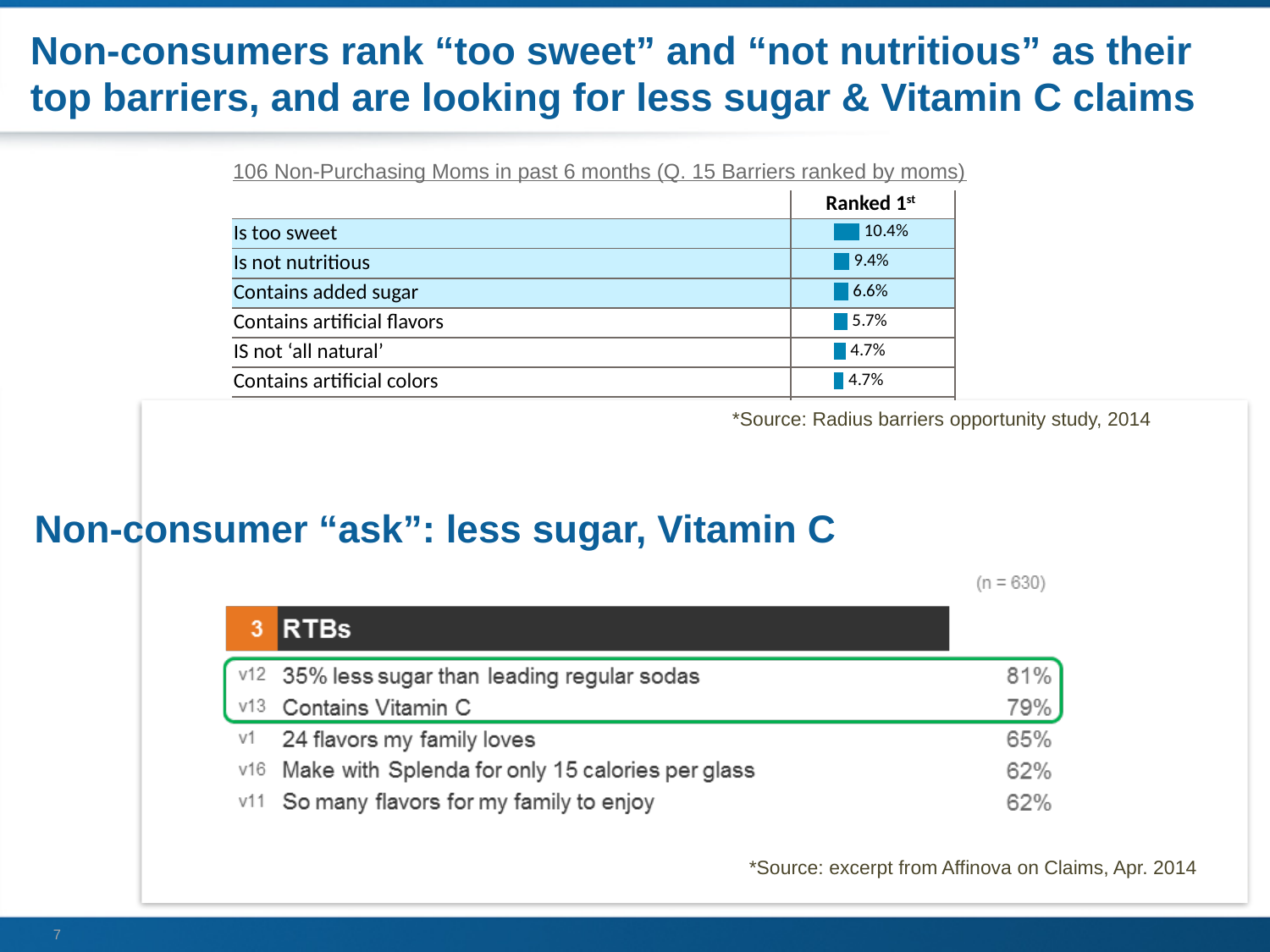
In the top chart of barriers ranked by moms, what is the difference between "Is too sweet" and "Is not nutritious"? 1.0% In the top chart of barriers ranked by moms, which barrier has the highest "Ranked 1st" value? Is too sweet In the bottom RTBs table, what is the difference between "35% less sugar than leading regular sodas" and "24 flavors my family loves"? 16% In the top chart of barriers ranked by moms, do the values rise or fall going down the list from "Is too sweet" to "Contains artificial colors"? Fall In the top chart of barriers ranked by moms, how many barriers are listed? 6 In the top chart of barriers ranked by moms, what is the value for "Contains artificial flavors"? 5.7% In the top chart of barriers ranked by moms, what kind of chart is used to show the "Ranked 1st" values? Bar chart In the top chart of barriers ranked by moms, what is the value for "Is too sweet"? 10.4% In the top chart of barriers ranked by moms, what is the value for "Is not nutritious"? 9.4% In the top chart of barriers ranked by moms, which is larger: "Contains added sugar" or "Contains artificial flavors"? Contains added sugar In the bottom RTBs table, what is the value for "Contains Vitamin C"? 79% In the top chart of barriers ranked by moms, what is the value for "Contains added sugar"? 6.6%